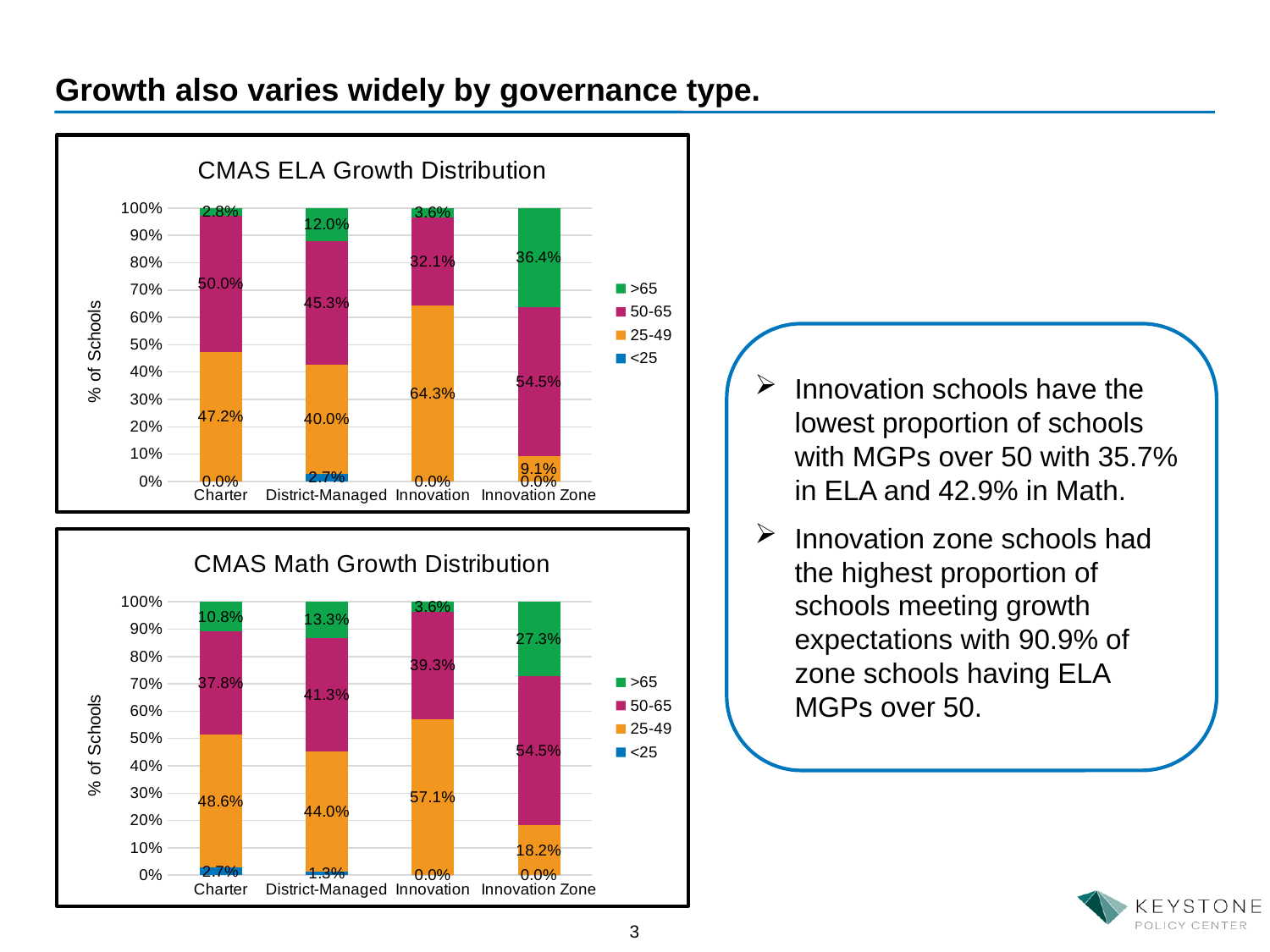
In the CMAS Math Growth Distribution chart, what is the combined share of Innovation Zone schools in the 50-65 and >65 bands? 81.8% In the CMAS Math Growth Distribution chart, which governance type has the lowest 25-49 value? Innovation Zone In the CMAS Math Growth Distribution chart, what is the <25 value for Charter schools? 2.7% In the CMAS ELA Growth Distribution chart, what percentage of Innovation schools fall in the 25-49 band? 64.3% How many series does the legend of the CMAS Math Growth Distribution chart list? 4 In the CMAS Math Growth Distribution chart, which is larger: the >65 value for Charter or for District-Managed? District-Managed In the CMAS ELA Growth Distribution chart, what is the difference between the 50-65 values for Innovation Zone and Innovation schools? 22.4% In the CMAS Math Growth Distribution chart, what is the 50-65 value for District-Managed schools? 41.3% In the CMAS ELA Growth Distribution chart, which governance type has the highest >65 value? Innovation Zone In the CMAS ELA Growth Distribution chart, what is the >65 value for Innovation Zone schools? 36.4% What type of chart is the CMAS ELA Growth Distribution chart? Stacked bar chart How many governance types are shown on the x axis of the CMAS ELA Growth Distribution chart? 4